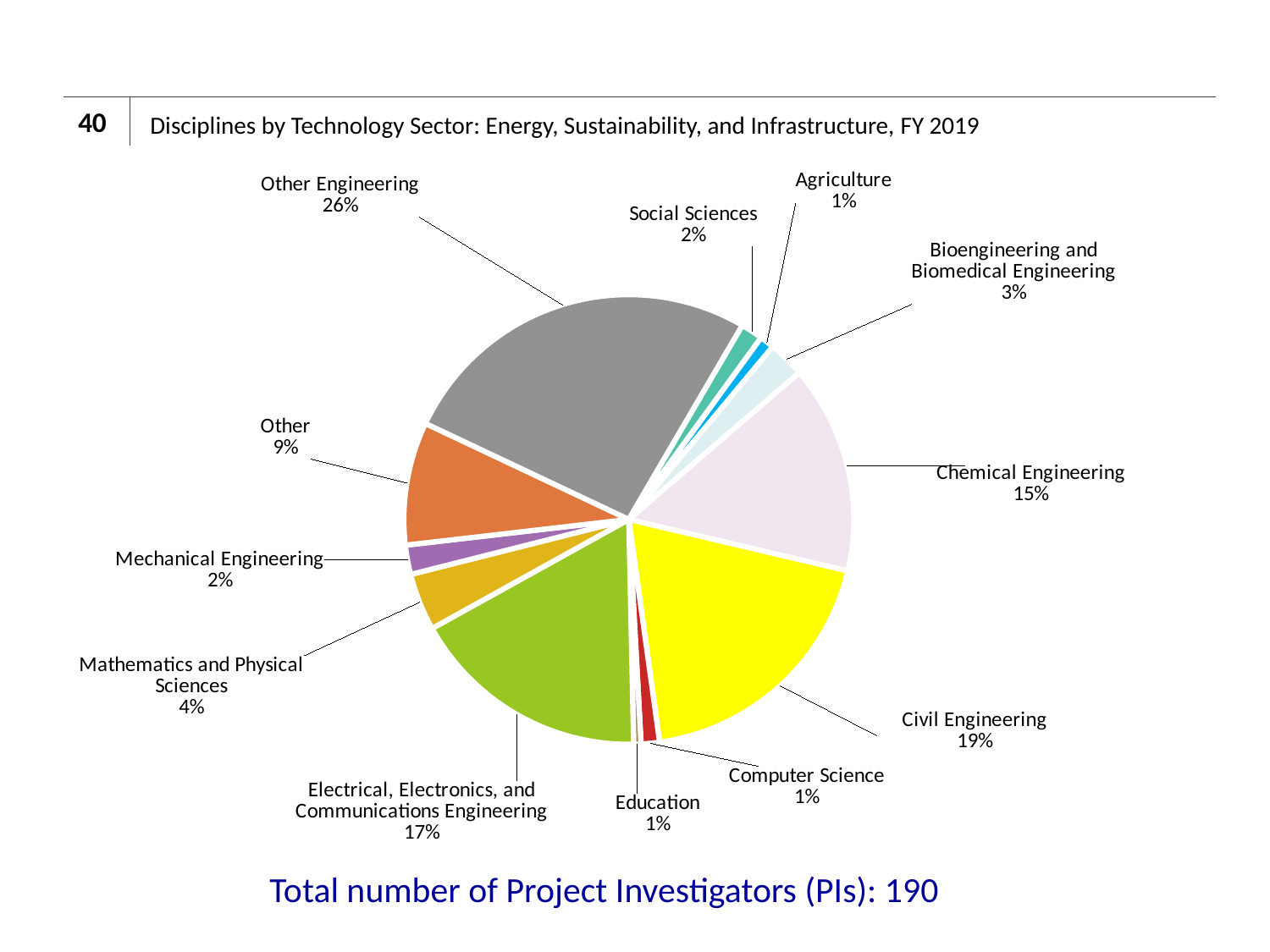
What percentage is shown for Chemical Engineering? 15% What share of the pie does Other Engineering represent? 26% What percentage is shown for Electrical, Electronics, and Communications Engineering? 17% What percentage is shown for Mathematics and Physical Sciences? 4% What is the title of the chart on the slide? Disciplines by Technology Sector: Energy, Sustainability, and Infrastructure, FY 2019 How many discipline slices are shown in the pie chart? 12 What is the total number of Project Investigators (PIs) stated on the slide? 190 What percentage is shown for Civil Engineering? 19% Which discipline has the largest share of the pie? Other Engineering What is the difference in percentage points between Civil Engineering and Chemical Engineering? 4 percentage points Which is larger, the share for Civil Engineering or the share for Chemical Engineering? Civil Engineering What kind of chart is shown on the slide? Pie chart